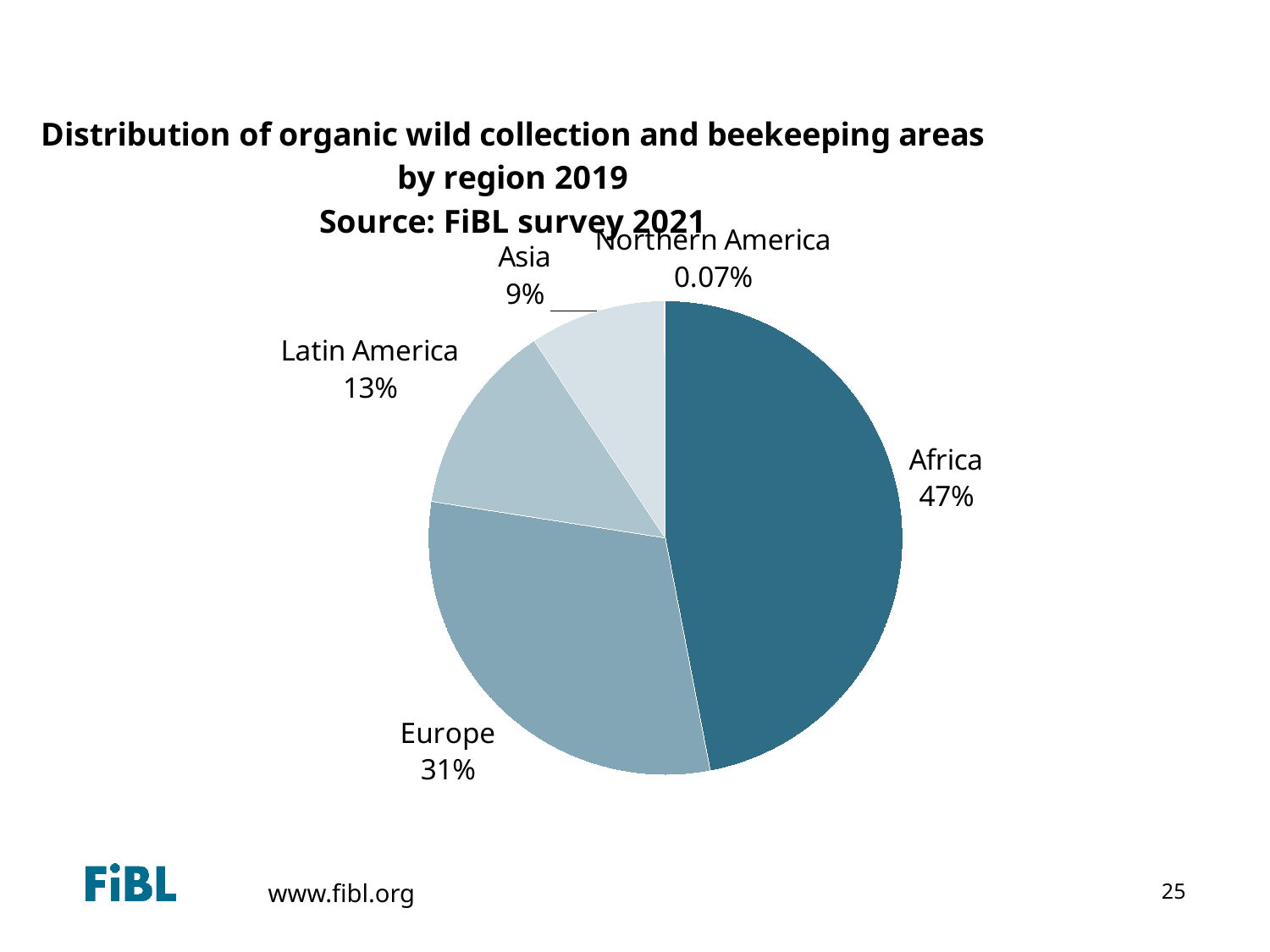
What is the value shown for Latin America? 13% What is the value shown for Asia? 9% How many percentage points larger is Africa's share than Europe's? 16 What is the source cited in the chart title? FiBL survey 2021 What type of chart is shown on the slide? Pie chart How many regions are shown in the pie chart? 5 What share of the organic wild collection and beekeeping areas does Africa account for? 47% What share of the pie does Europe represent? 31% Which region has the smallest share of the pie? Northern America Which has a larger share, Latin America or Asia? Latin America Which region has the largest share of the pie? Africa What is the value shown for Northern America? 0.07%